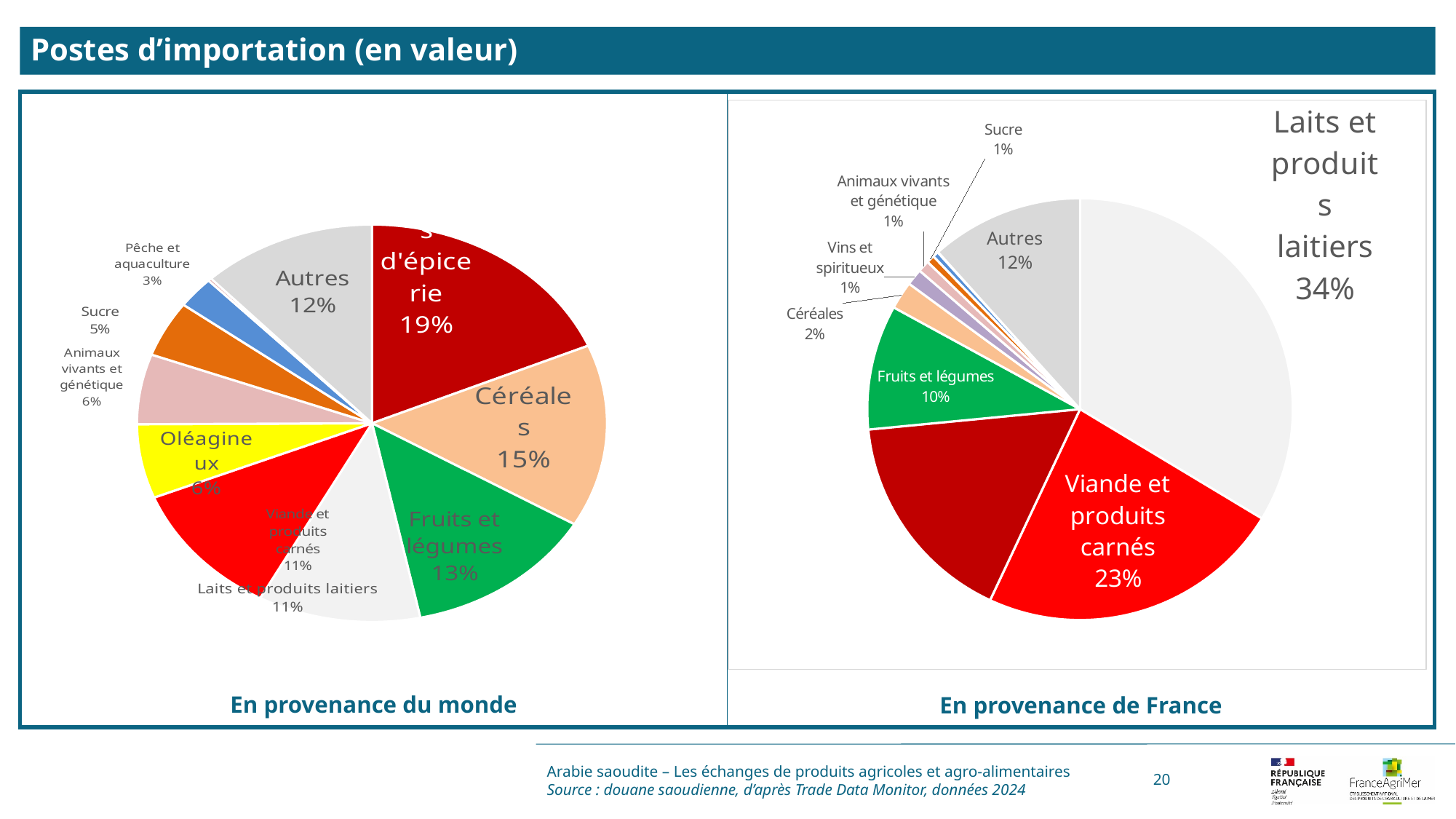
In the 'En provenance du monde' pie chart, what share do Céréales represent? 15% In the 'En provenance de France' pie chart, what share do Viande et produits carnés represent? 23% In the 'En provenance du monde' pie chart, what is the share of Pêche et aquaculture? 3% In the 'En provenance du monde' pie chart, what share do Fruits et légumes represent? 13% In the 'En provenance de France' pie chart, which category has the largest share? Laits et produits laitiers In the 'En provenance de France' pie chart, what share do Laits et produits laitiers represent? 34% In the 'En provenance du monde' pie chart, which is larger: Oléagineux or Sucre? Oléagineux What type of chart is used on this slide? Pie chart In the 'En provenance de France' pie chart, what is the difference between the shares of Laits et produits laitiers and Viande et produits carnés? 11 percentage points In the 'En provenance du monde' pie chart, which labelled category has the smallest share? Pêche et aquaculture What is the title of the slide? Postes d'importation (en valeur) In the 'En provenance du monde' pie chart, what is the difference between the shares of Céréales and Sucre? 10 percentage points